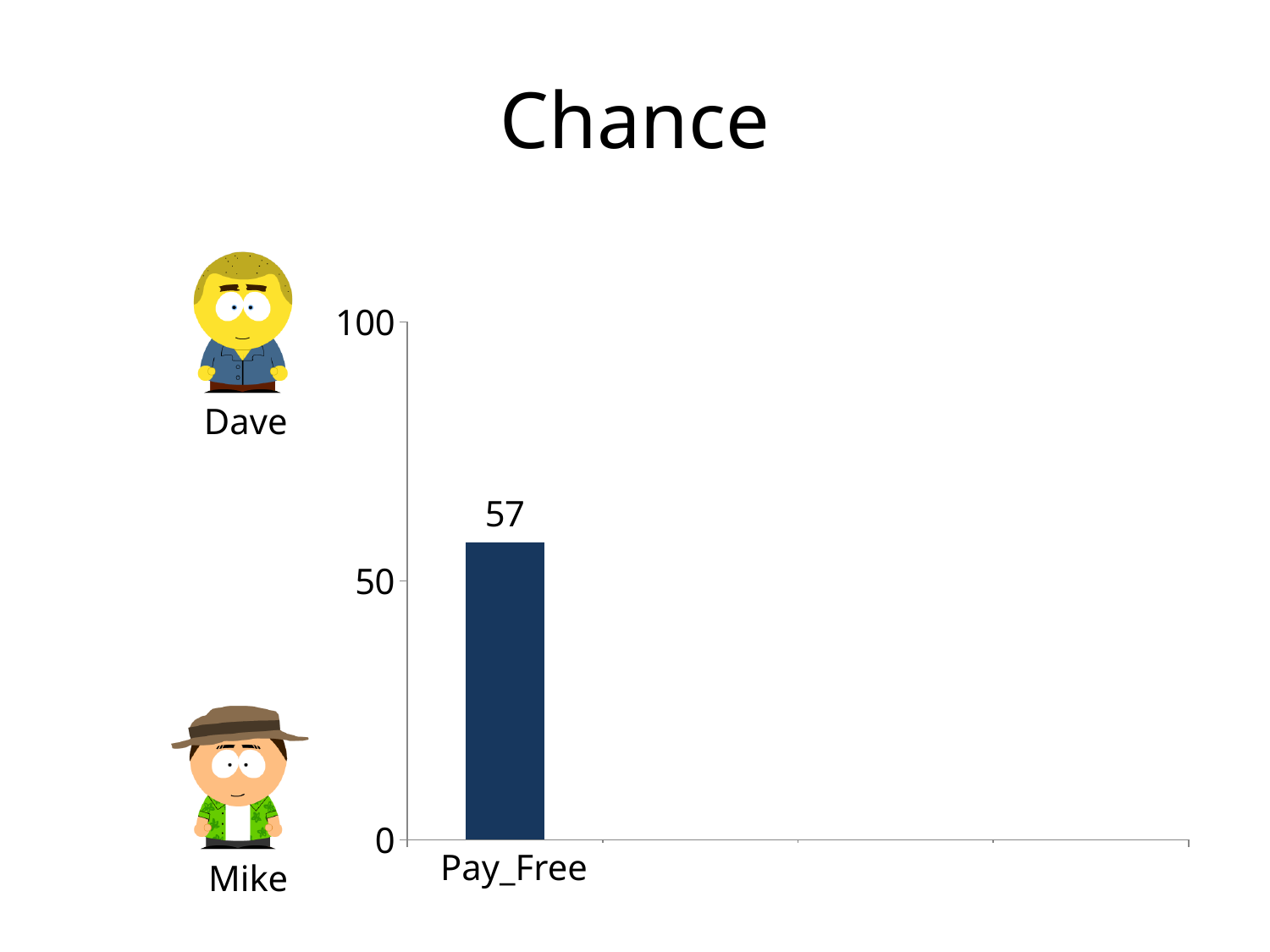
Is the value for Pay_Free greater or less than 100? less What is the label of the category on the x axis? Pay_Free What is the highest value shown on the y axis? 100 Is the value for Pay_Free greater or less than 50? greater What is the title of the slide containing the chart? Chance What kind of chart is shown on the slide? bar chart What is the value of the Pay_Free bar? 57 How many bars are plotted in the chart? 1